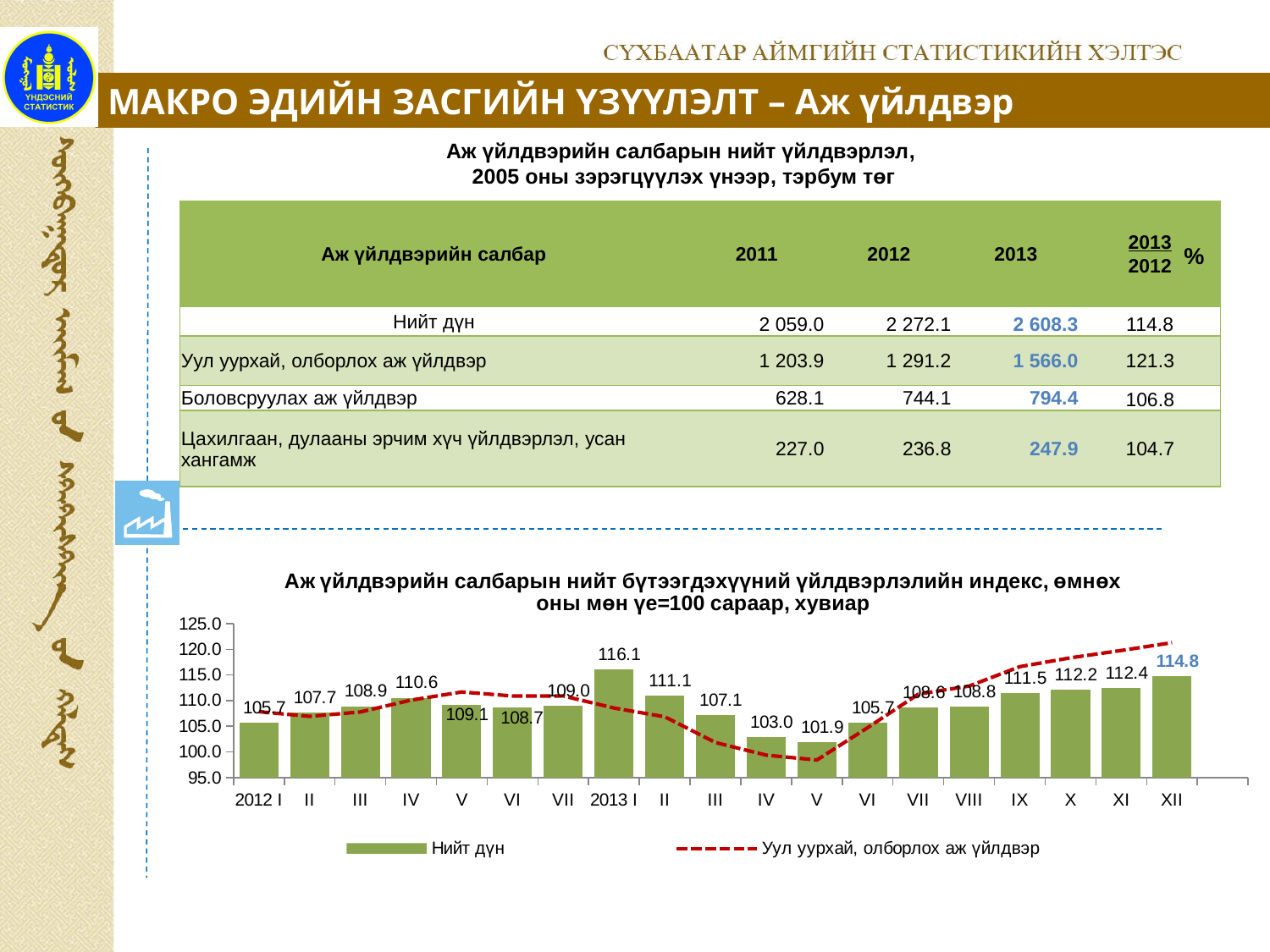
What is the Нийт дүн value for 2012 IV? 110.6 How many bars are plotted in the chart? 19 What is the Нийт дүн value for 2013 I? 116.1 What is the difference between the Нийт дүн values for 2013 I and 2013 V? 14.2 Do the Нийт дүн bars rise or fall from 2013 V to 2013 XII? rise How many series does the chart legend list? 2 Which period has the highest Нийт дүн bar? 2013 I What is the Нийт дүн value for 2013 XII? 114.8 Which period has the lowest Нийт дүн bar? 2013 V What type of chart is shown at the bottom of the slide? bar chart with a line Which is larger, the Нийт дүн value for 2013 IX or for 2013 III? 2013 IX Which series is drawn as a red dashed line in the chart? Уул уурхай, олборлох аж үйлдвэр